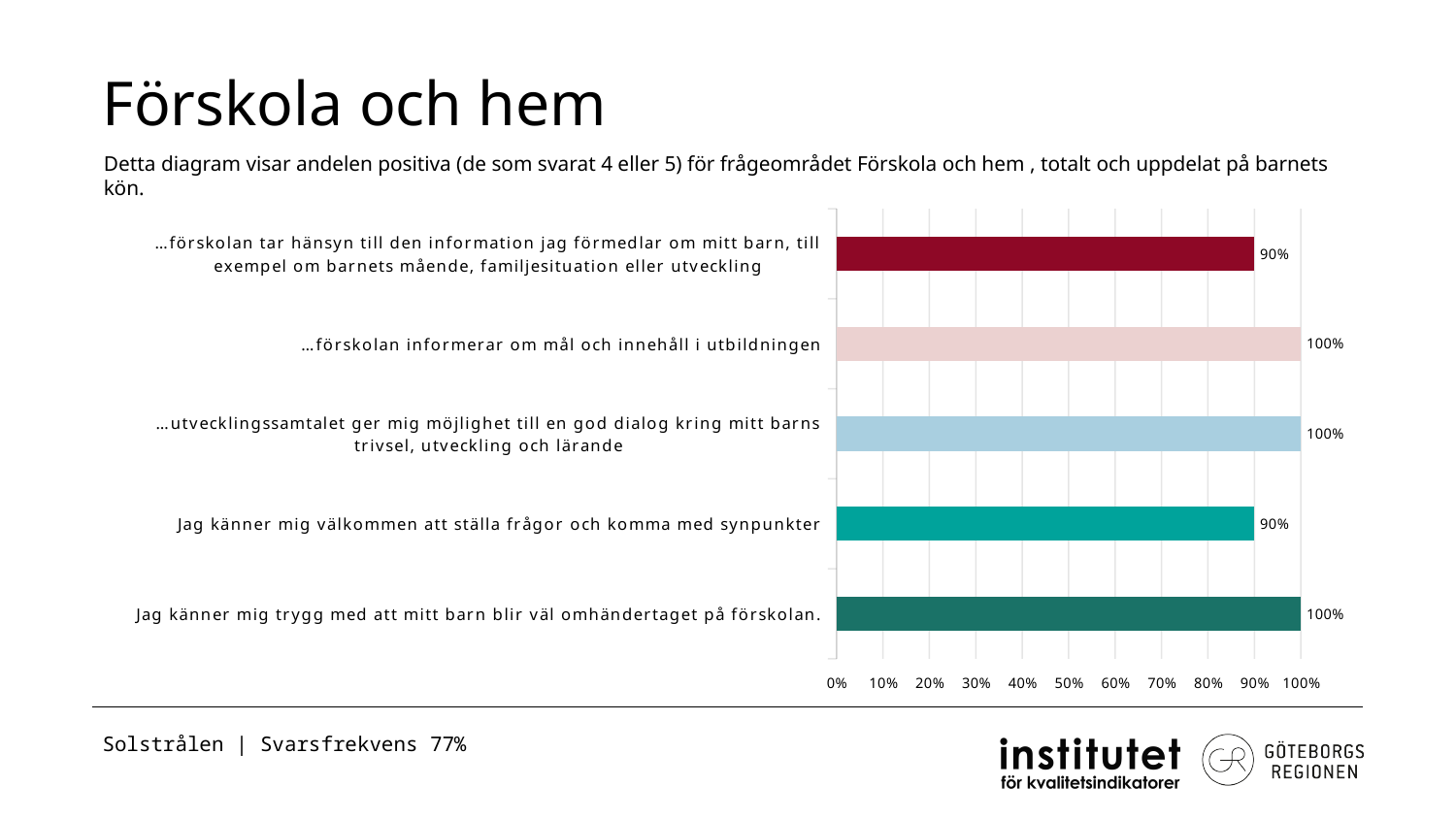
How many categories are shown in the chart? 5 What value is shown for "Jag känner mig trygg med att mitt barn blir väl omhändertaget på förskolan."? 100% Which is larger: the value for "Jag känner mig trygg med att mitt barn blir väl omhändertaget på förskolan." or the value for "Jag känner mig välkommen att ställa frågor och komma med synpunkter"? Jag känner mig trygg med att mitt barn blir väl omhändertaget på förskolan. What is the difference between the value for "…förskolan informerar om mål och innehåll i utbildningen" and the value for "Jag känner mig välkommen att ställa frågor och komma med synpunkter"? 10% What is the title of the slide containing the chart? Förskola och hem What is the highest value shown on the x axis of the chart? 100% What kind of chart is shown on the slide? bar chart What value is shown for "…utvecklingssamtalet ger mig möjlighet till en god dialog kring mitt barns trivsel, utveckling och lärande"? 100% What value is shown for "…förskolan tar hänsyn till den information jag förmedlar om mitt barn, till exempel om barnets mående, familjesituation eller utveckling"? 90% What value is shown for "…förskolan informerar om mål och innehåll i utbildningen"? 100% Is the value for "Jag känner mig välkommen att ställa frågor och komma med synpunkter" greater or less than 80%? greater What value is shown for "Jag känner mig välkommen att ställa frågor och komma med synpunkter"? 90%